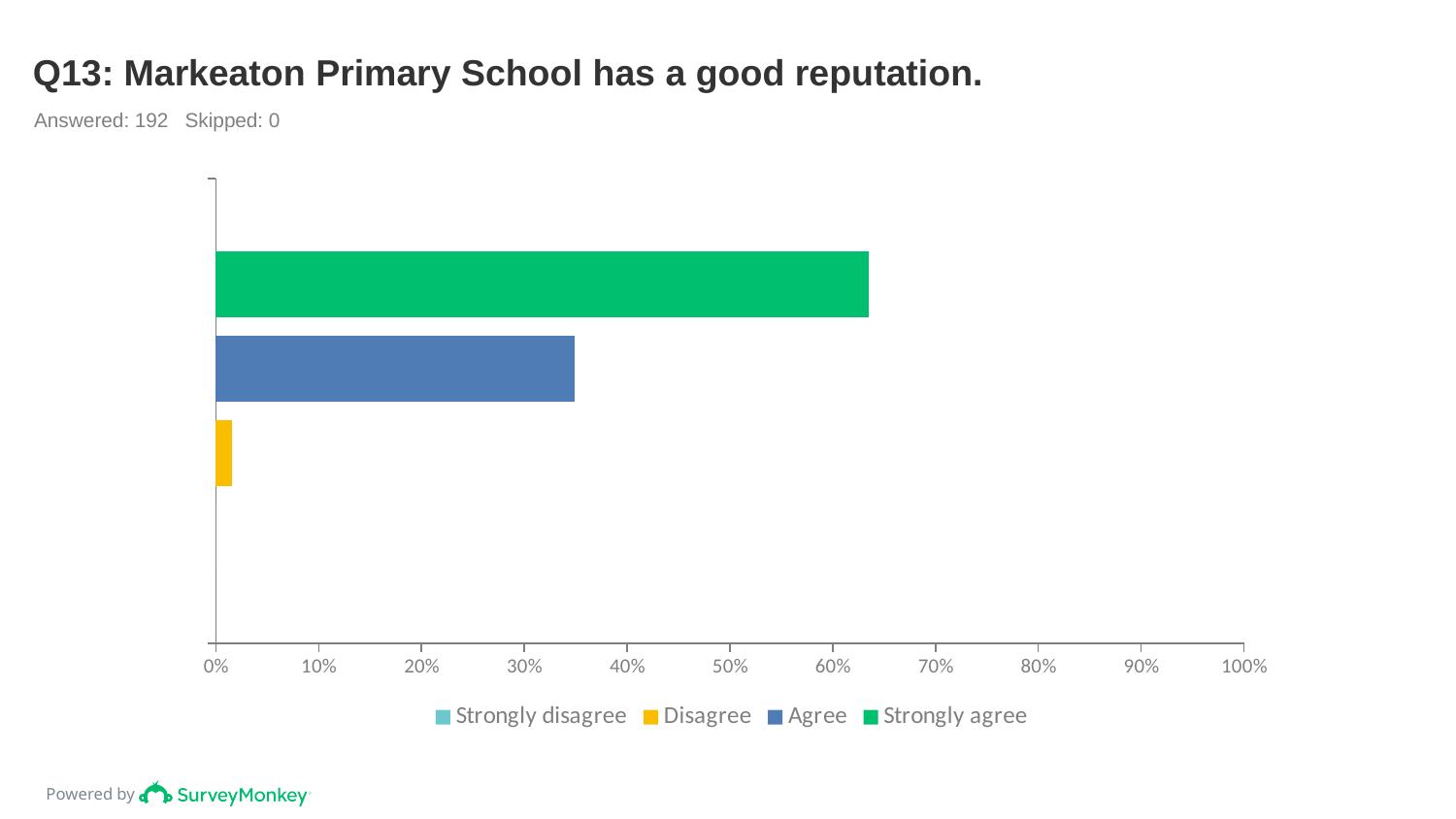
How many series does the legend list? 4 Which response option has the longest bar? Strongly agree Which is larger, the value for Agree or the value for Disagree? Agree Is the value for Agree greater or less than 30%? greater Is the value for Agree greater or less than 40%? less Is the value for Strongly agree greater or less than 70%? less Which is larger, the value for Strongly agree or the value for Agree? Strongly agree What kind of chart is shown on the slide? Bar chart What is the title of the chart? Q13: Markeaton Primary School has a good reputation. How many respondents answered the question according to the slide? 192